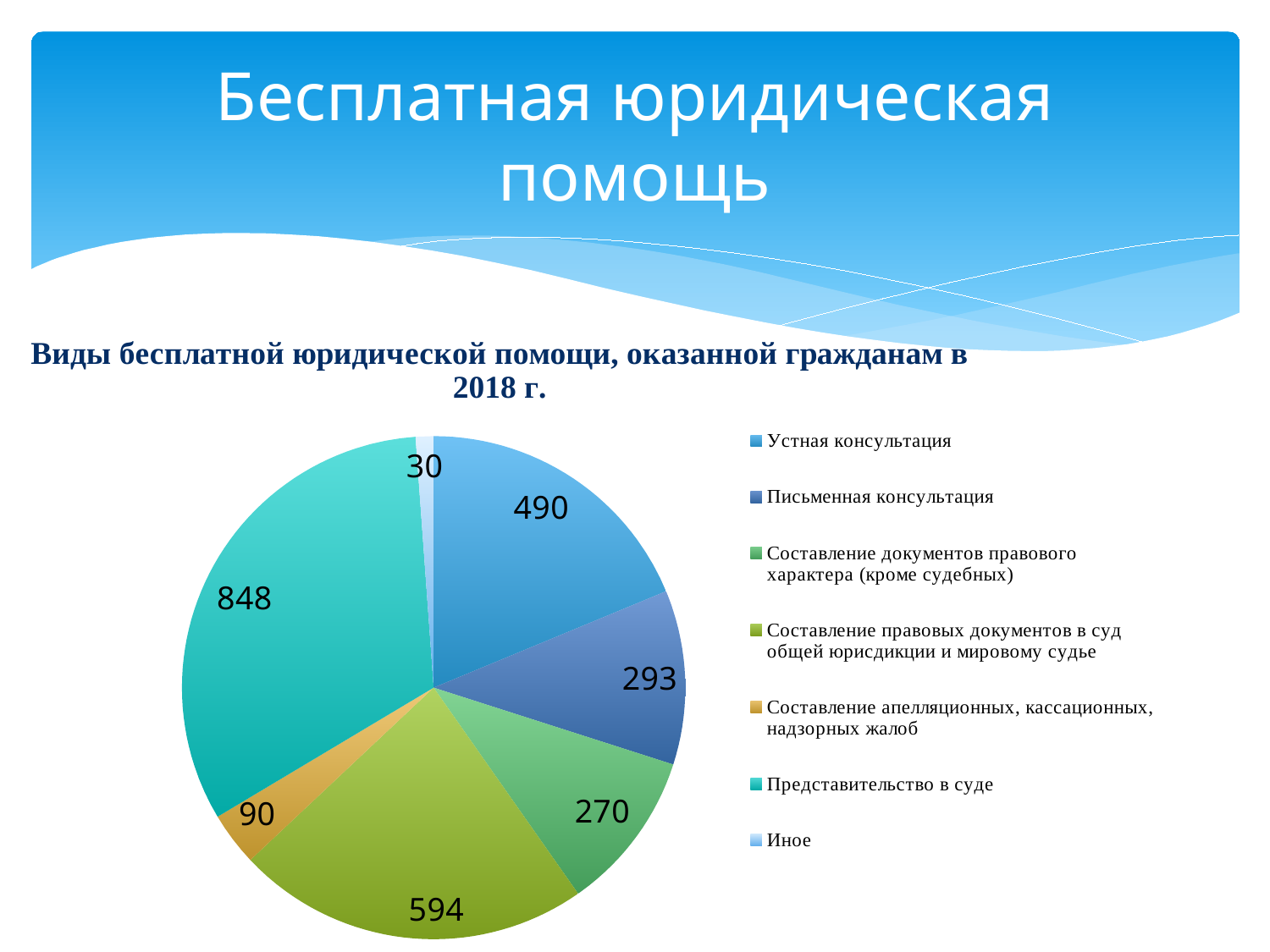
What is the value for Составление апелляционных, кассационных, надзорных жалоб? 90 What is the value for Устная консультация? 490 What is the value for Иное? 30 What is the difference between the values for Представительство в суде and Составление правовых документов в суд общей юрисдикции и мировому судье? 254 Which is larger: Письменная консультация or Составление документов правового характера (кроме судебных)? Письменная консультация What is the total of all the values shown in the pie chart? 2615 What is the value for Представительство в суде? 848 What type of chart is shown on the slide? pie chart Which category has the smallest slice of the pie? Иное Which category has the largest slice of the pie? Представительство в суде What is the title of the chart? Виды бесплатной юридической помощи, оказанной гражданам в 2018 г. How many categories does the pie chart show? 7